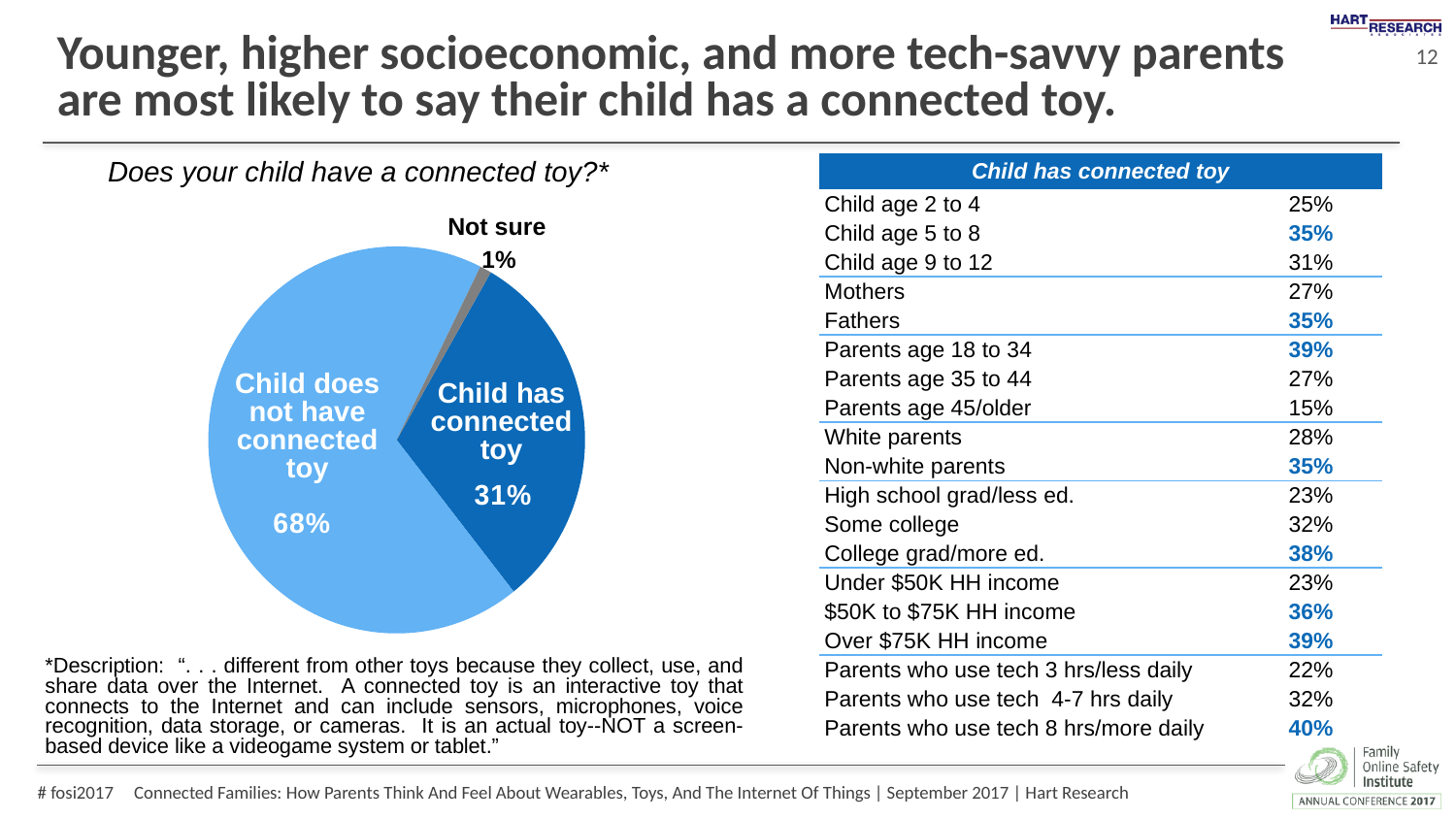
Which slice of the pie chart is the smallest? Not sure What is the question shown as the title above the pie chart? Does your child have a connected toy?* What percentage of the pie chart is labelled "Not sure"? 1% How many slices does the pie chart have? 3 Which slice of the pie chart is the largest? Child does not have connected toy What percentage of the pie chart is labelled "Child does not have connected toy"? 68% What is the difference in percentage points between the "Child does not have connected toy" slice and the "Child has connected toy" slice? 37 percentage points What percentage of the pie chart is labelled "Child has connected toy"? 31% What kind of chart is shown on the slide? pie chart Which is larger in the pie chart: "Child has connected toy" or "Not sure"? Child has connected toy What share of the pie does the "Child has connected toy" slice represent? 31% What colour is the "Child has connected toy" slice of the pie chart? dark blue